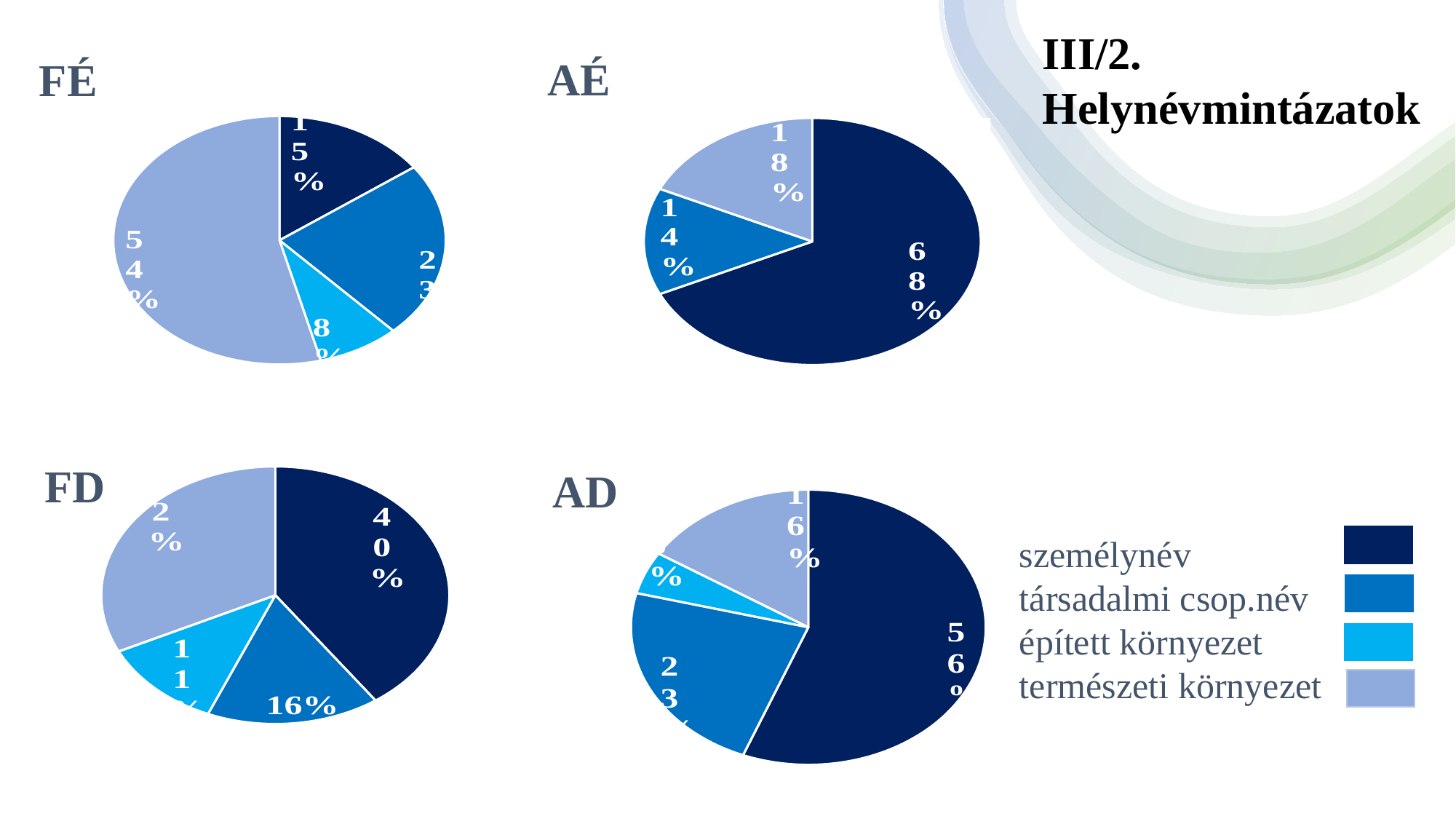
In the FÉ pie chart, what share does természeti környezet have? 54% In the FÉ pie chart, what share does személynév have? 15% In the FD pie chart, which category has the largest slice? személynév How many slices does the AÉ pie chart have? 3 In the AÉ pie chart, which category has the smallest slice? társadalmi csop.név In the AÉ pie chart, what share does személynév have? 68% How many categories does the legend list? 4 In the AÉ pie chart, what is the difference between the személynév share and the természeti környezet share? 50 percentage points In the AD pie chart, what share does személynév have? 56% In the FD pie chart, what share does társadalmi csop.név have? 16% In the FÉ pie chart, which category has the smallest slice? épített környezet Which is larger: the személynév share in the FÉ chart or in the AÉ chart? AÉ